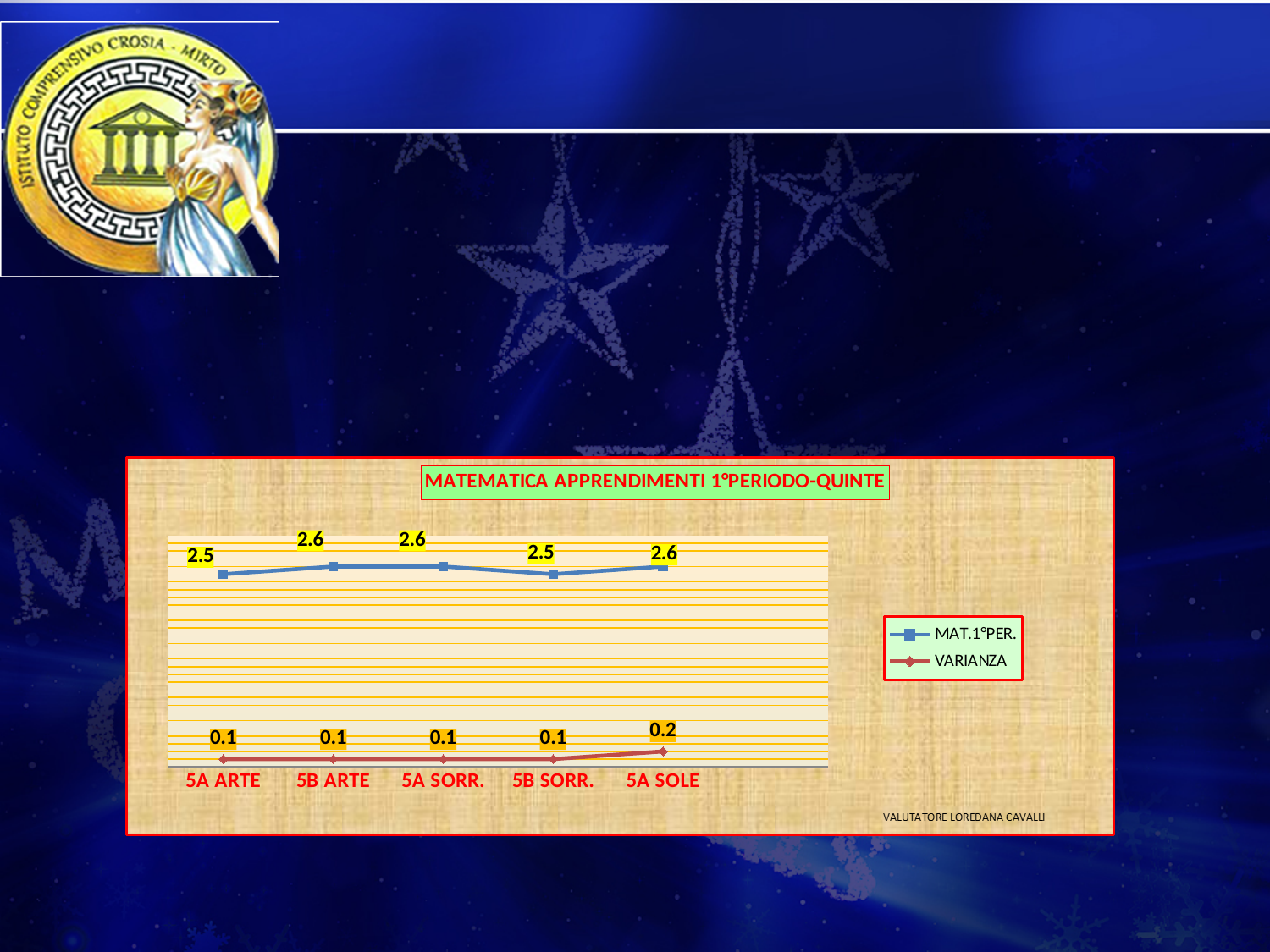
What is the VARIANZA value for 5B ARTE? 0.1 What colour is the line for the VARIANZA series? Red How many categories are shown on the x axis? 5 What is the title of the chart? MATEMATICA APPRENDIMENTI 1°PERIODO-QUINTE Which category has the highest VARIANZA value? 5A SOLE What is the MAT.1°PER. value for 5A ARTE? 2.5 Which is larger, the MAT.1°PER. value for 5A SORR. or for 5B SORR.? 5A SORR. What is the VARIANZA value for 5A SOLE? 0.2 How many series does the legend list? 2 What is the difference between the MAT.1°PER. values for 5B ARTE and 5A ARTE? 0.1 What is the MAT.1°PER. value for 5B SORR.? 2.5 What kind of chart is shown on the slide? Line chart